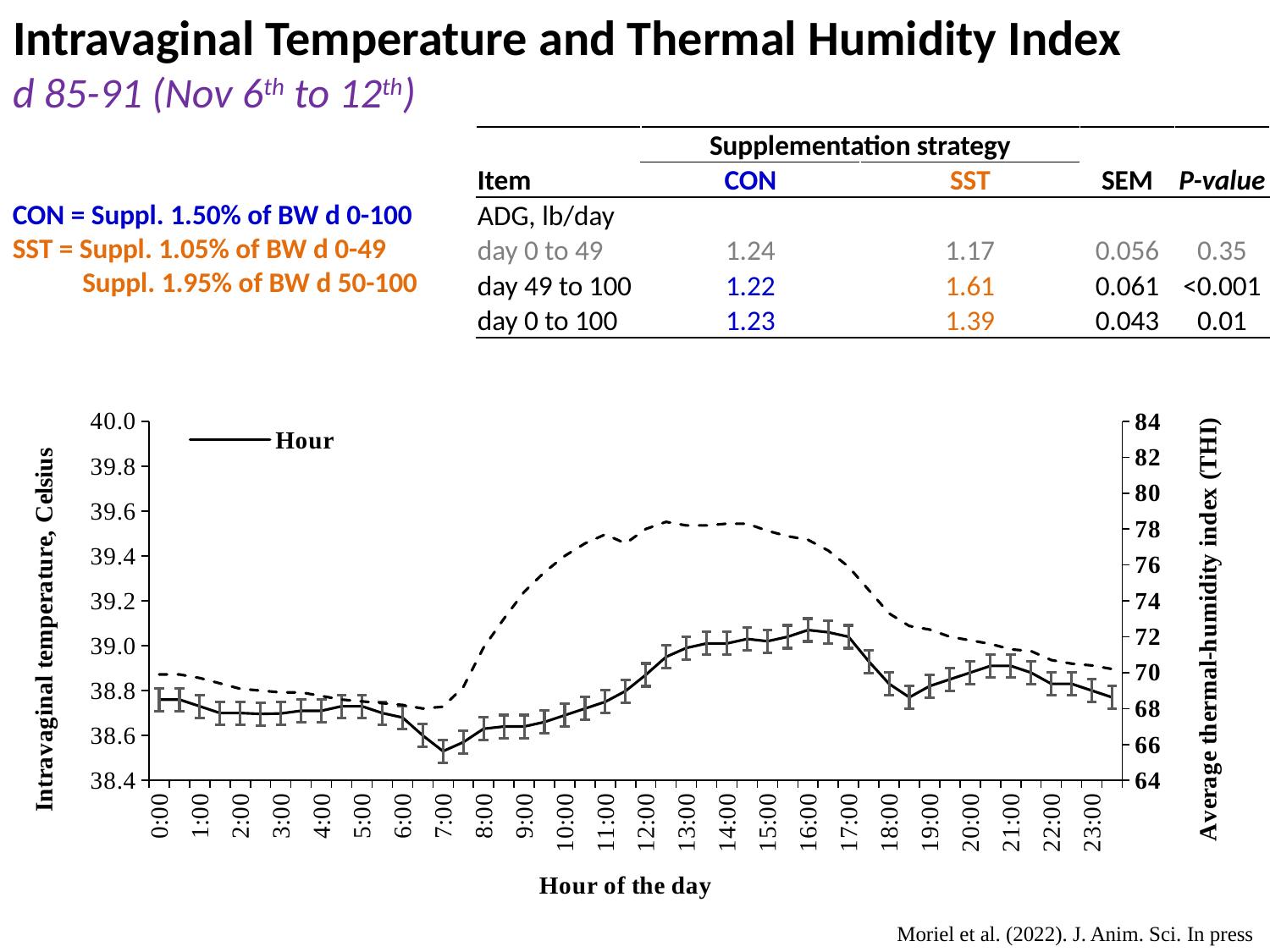
At which hour of the day is the solid intravaginal temperature line at its highest? 16:00 Does the dashed thermal-humidity index line rise or fall between 14:00 and 18:00? fall At which hour of the day is the solid intravaginal temperature line at its lowest? 7:00 What kind of chart is shown on the slide? line chart Is the intravaginal temperature (solid line) at 7:00 greater or less than 38.6? less Does the solid intravaginal temperature line rise or fall between 7:00 and 16:00? rise How many entries does the chart legend list? 1 What is the title of the right-hand vertical axis of the chart? Average thermal-humidity index (THI) Is the intravaginal temperature (solid line) at 16:00 greater or less than 39.0? greater